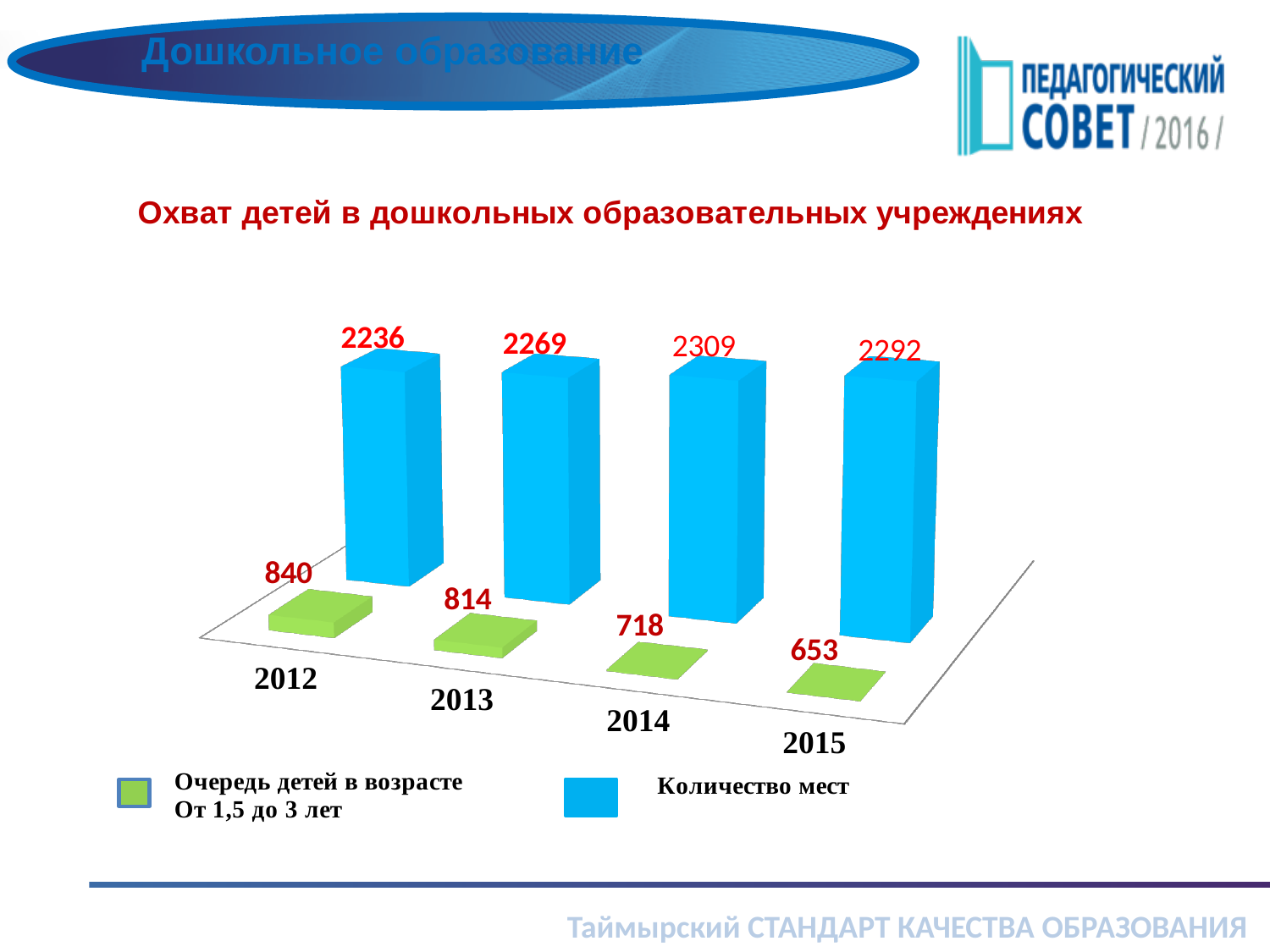
What kind of chart is shown? bar chart What is the value of "Очередь детей в возрасте от 1,5 до 3 лет" for 2015? 653 What is the value of "Количество мест" for 2014? 2309 In which year is "Количество мест" highest? 2014 In which year is "Очередь детей в возрасте от 1,5 до 3 лет" lowest? 2015 Does "Очередь детей в возрасте от 1,5 до 3 лет" rise or fall from 2012 to 2015? fall How many years are shown on the x axis? 4 How many series does the legend list? 2 What is the difference between "Очередь детей в возрасте от 1,5 до 3 лет" in 2012 and in 2015? 187 Which is larger: "Количество мест" in 2013 or in 2015? 2015 What is the value of "Очередь детей в возрасте от 1,5 до 3 лет" for 2012? 840 What is the difference between "Количество мест" in 2015 and in 2012? 56